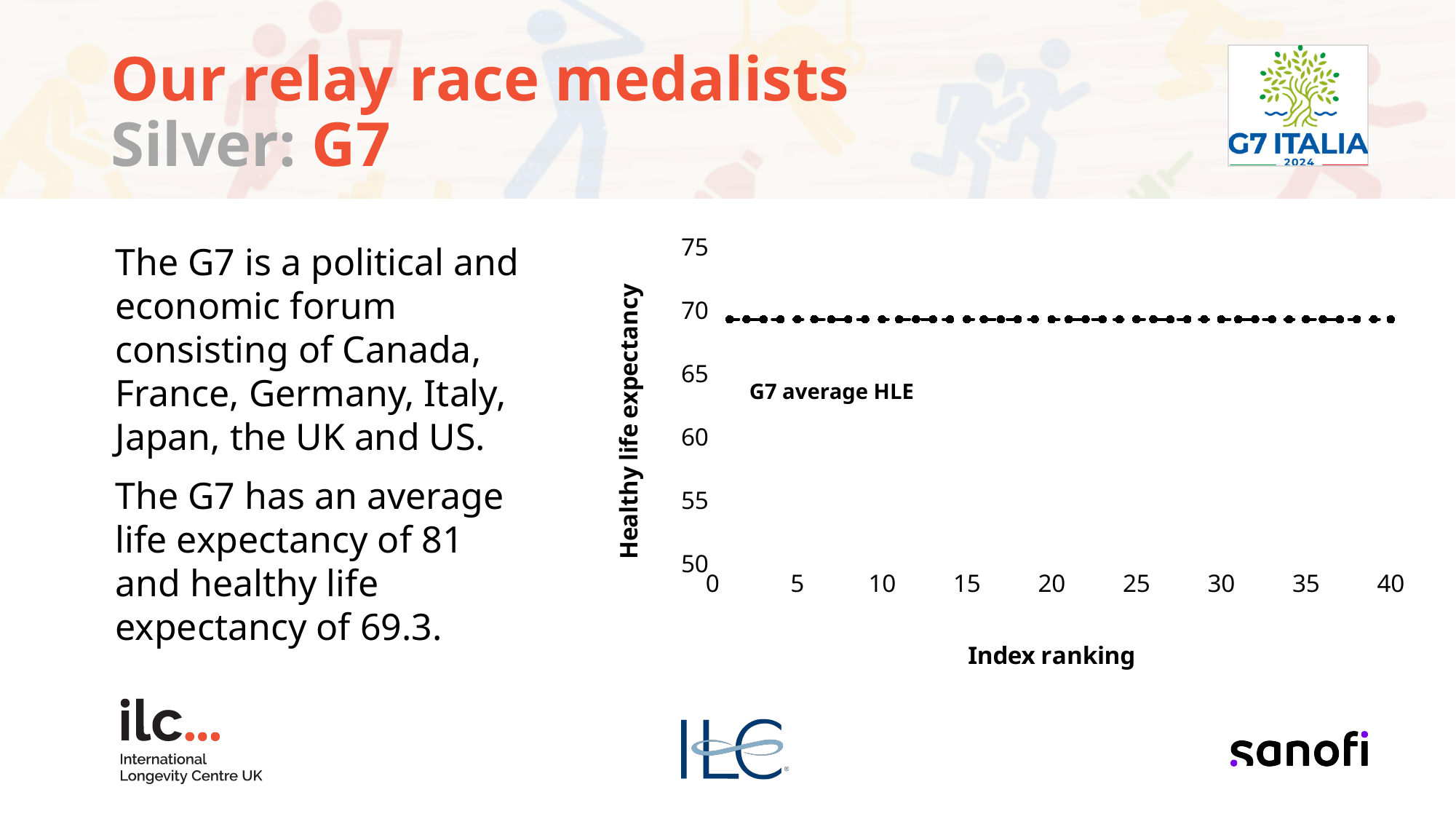
What kind of chart is shown on the slide? line chart Is the value of the G7 average HLE line greater or less than 60? greater What label is printed next to the dashed line on the chart? G7 average HLE Is the value of the G7 average HLE line greater or less than 65? greater Is the value of the G7 average HLE line greater or less than 70? less What is the label of the vertical axis of the chart? Healthy life expectancy Does the G7 average HLE line rise, fall, or stay flat as the index ranking increases along the x axis? stays flat According to the slide, what is the G7 average healthy life expectancy shown by the dashed line? 69.3